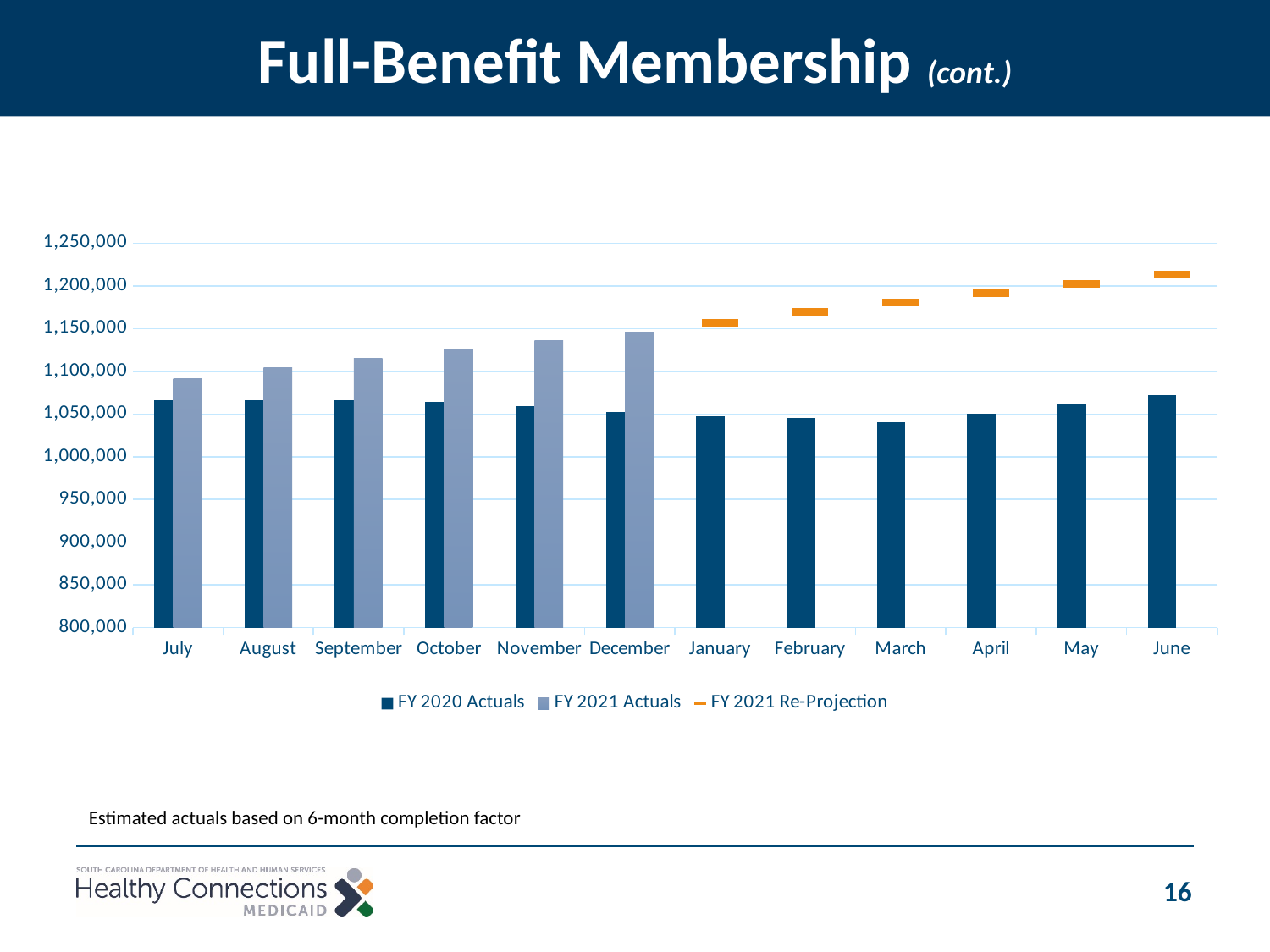
Do the FY 2021 Actuals values rise or fall from July to December? rise For how many months are FY 2021 Actuals bars plotted? 6 Is the FY 2020 Actuals value for March greater or less than 1,050,000? less How many series does the legend list? 3 Which month has the highest FY 2021 Actuals value? December Which month has the lowest FY 2020 Actuals value? March In July, which is larger: FY 2020 Actuals or FY 2021 Actuals? FY 2021 Actuals How many months are shown along the x axis? 12 Is the FY 2021 Re-Projection value for March greater or less than 1,150,000? greater Is the FY 2021 Actuals value for December greater or less than 1,100,000? greater What kind of chart is shown on the slide? bar chart